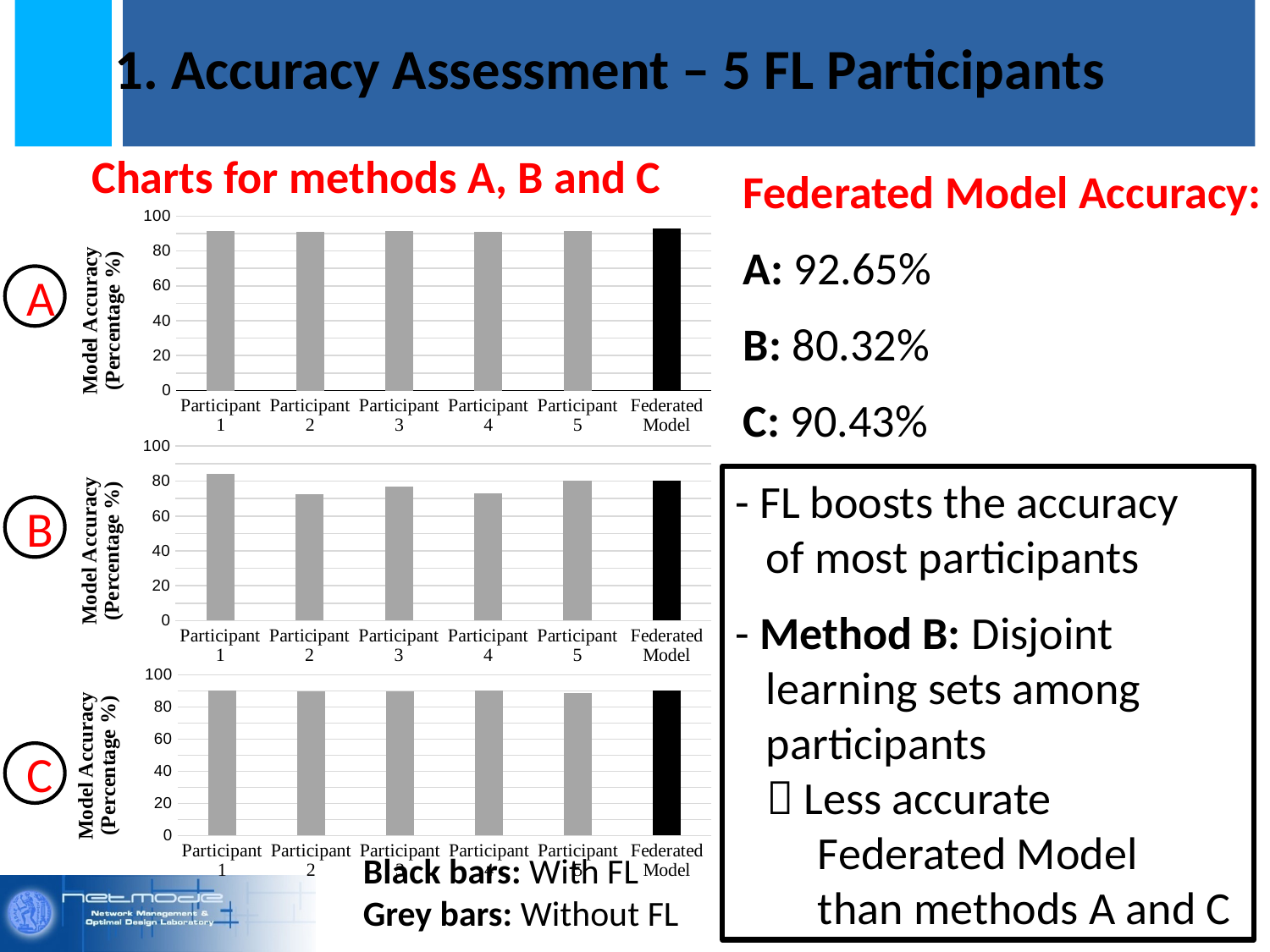
How many categories are shown on the x axis of chart B (the middle chart)? 6 In chart A (the top chart), is the value for Participant 3 greater or less than 80? greater What kind of chart is chart A (the top chart)? bar chart In chart B (the middle chart), which is larger, the value for Participant 5 or the value for Participant 4? Participant 5 In chart B (the middle chart), is the value for Participant 2 greater or less than 80? less What is the y-axis label of chart C (the bottom chart)? Model Accuracy (Percentage %) In chart C (the bottom chart), is the value for Participant 5 greater or less than 80? greater In chart B (the middle chart), which participant has the highest model accuracy? Participant 1 According to the slide, what is the Federated Model accuracy for method B? 80.32% According to the slide, what is the Federated Model accuracy for method A? 92.65% In chart B (the middle chart), which is larger, the value for Participant 1 or the value for Participant 2? Participant 1